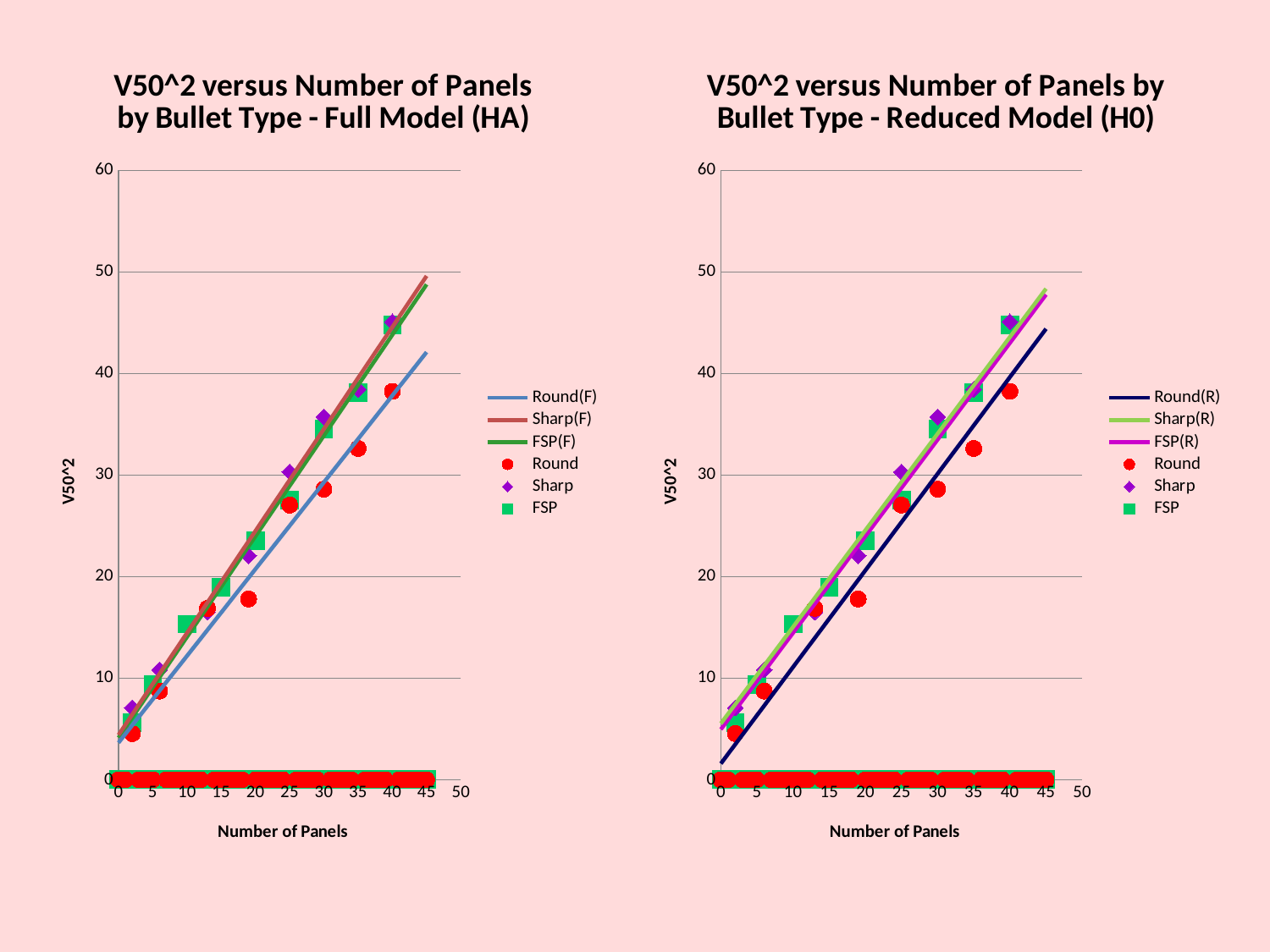
In the right chart (Reduced Model (H0)), is the Sharp value at 40 panels greater or less than 40? greater What is the x-axis label of the right chart (Reduced Model (H0))? Number of Panels In the left chart (Full Model (HA)), at 40 panels, which is larger: the Sharp value or the Round value? Sharp In the right chart (Reduced Model (H0)), is the FSP value at 10 panels greater or less than 20? less What are the three fitted-line series named in the legend of the right chart (Reduced Model (H0))? Round(R), Sharp(R), FSP(R) How many series does the legend of the left chart (Full Model (HA)) list? 6 In the right chart (Reduced Model (H0)), do the V50^2 values rise or fall as the number of panels increases? Rise In the left chart (Full Model (HA)), is the Round value at 40 panels greater or less than 30? greater In the left chart (Full Model (HA)), do the V50^2 values rise or fall as the number of panels increases? Rise How many series does the legend of the right chart (Reduced Model (H0)) list? 6 What kind of chart is the left chart, 'V50^2 versus Number of Panels by Bullet Type - Full Model (HA)'? Scatter chart with fitted lines